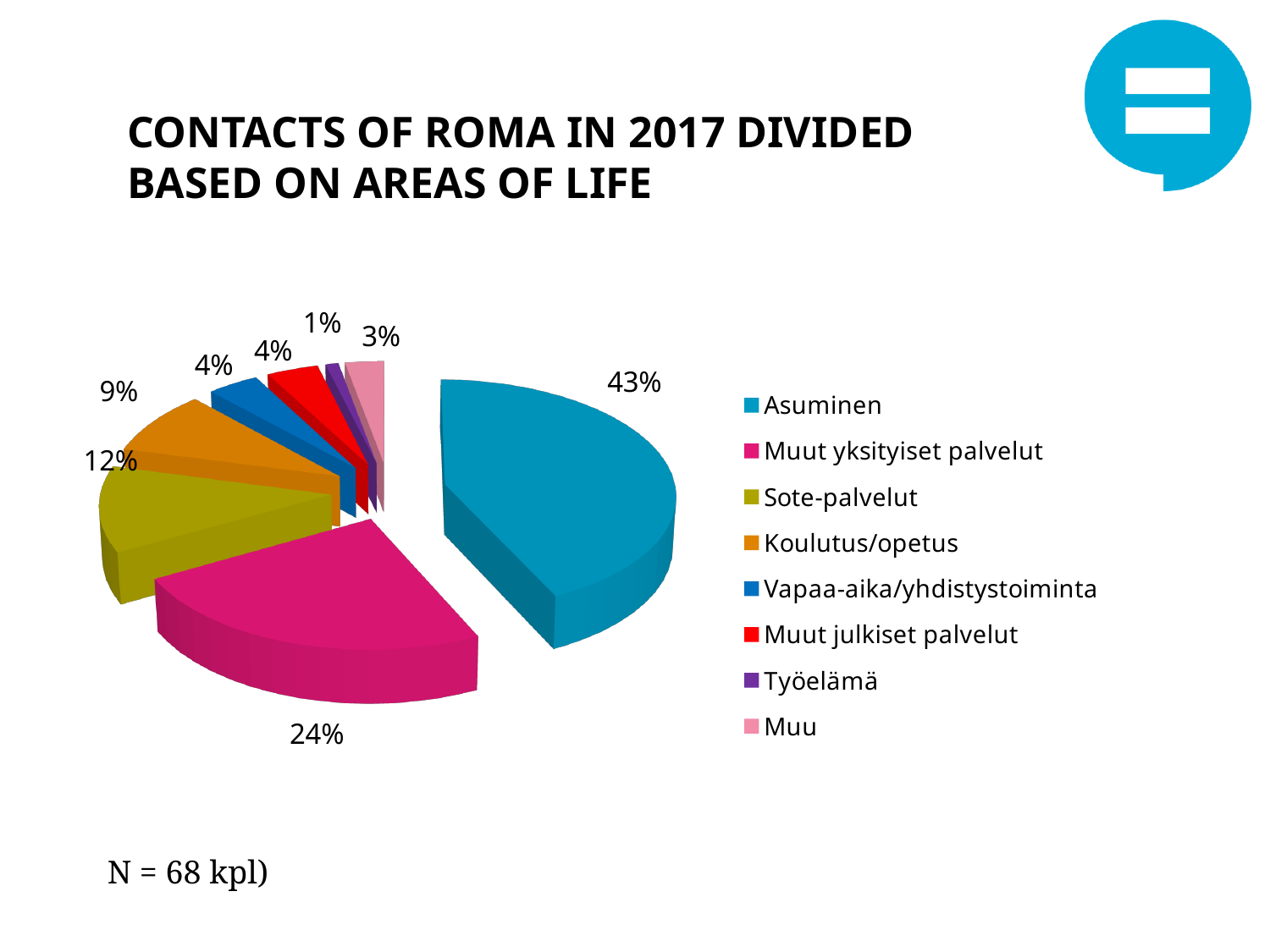
What share of contacts does Sote-palvelut account for? 12% How many categories does the legend list? 8 What share of contacts does Työelämä account for? 1% Which area of life has the smallest share of contacts? Työelämä What is the difference in percentage points between Asuminen and Muut yksityiset palvelut? 19 percentage points Which area of life has the largest share of contacts? Asuminen Which has a larger share, Sote-palvelut or Koulutus/opetus? Sote-palvelut What share of contacts does Koulutus/opetus account for? 9% What share of contacts does Muut yksityiset palvelut account for? 24% What share of contacts does Muu account for? 3% What kind of chart is shown on the slide? Pie chart What share of contacts does Asuminen account for? 43%